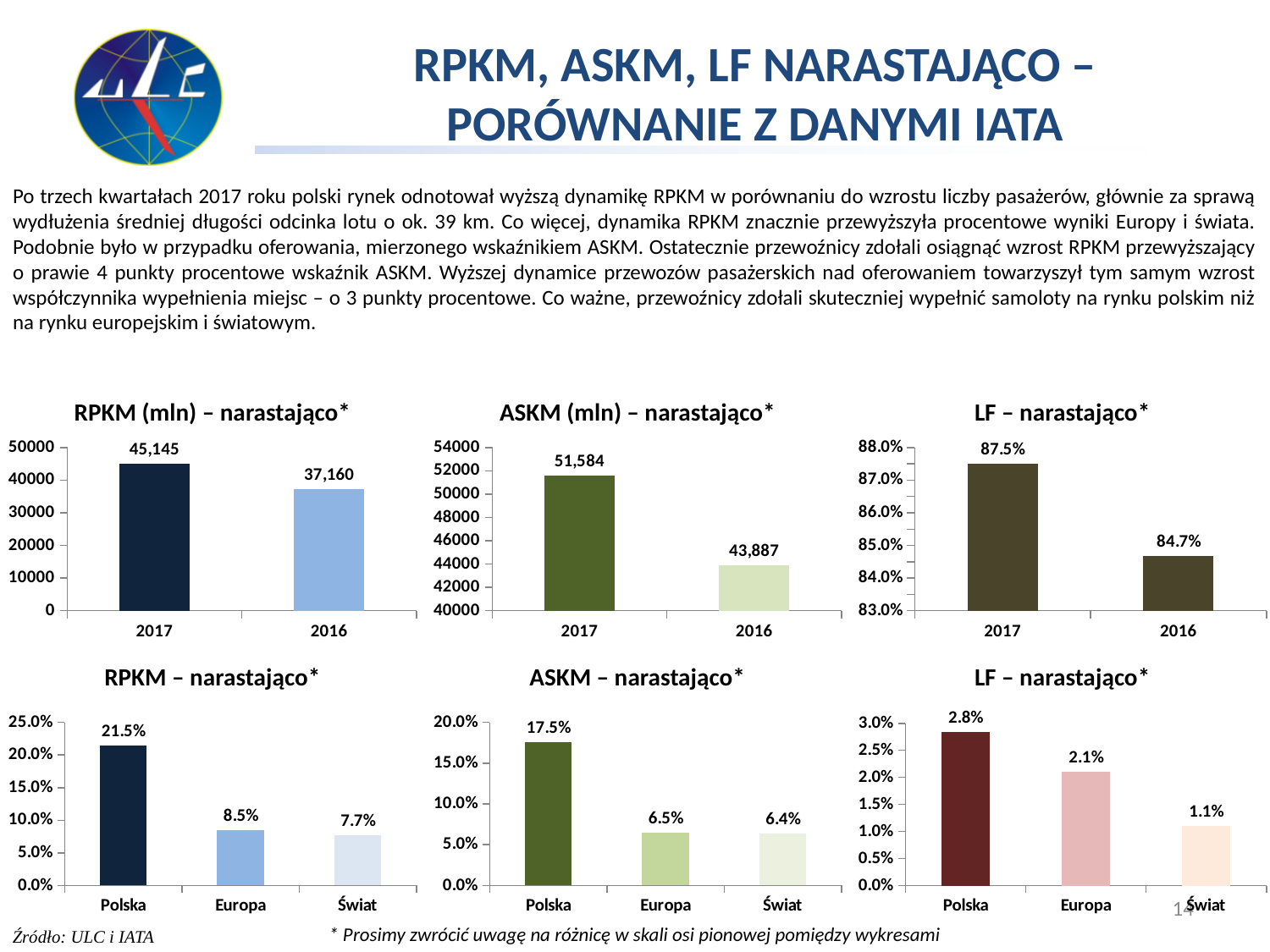
In the top-left chart 'RPKM (mln) – narastająco*', what is the value for 2017? 45,145 In the top-right chart 'LF – narastająco*', what is the difference between the 2017 and 2016 values? 2.8% In the top-middle chart 'ASKM (mln) – narastająco*', what is the value for 2016? 43,887 In the bottom-left chart 'RPKM – narastająco*', which category has the highest value? Polska What type of chart is the bottom-middle chart 'ASKM – narastająco*'? bar chart In the bottom-right chart 'LF – narastająco*', what is the value for Polska? 2.8% In the bottom-left chart 'RPKM – narastająco*', how many categories are shown? 3 In the bottom-right chart 'LF – narastająco*', which category has the lowest value? Świat In the top-left chart 'RPKM (mln) – narastająco*', what is the difference between the 2017 and 2016 values? 7,985 In the top-middle chart 'ASKM (mln) – narastająco*', is the value for 2017 larger or smaller than the value for 2016? larger In the top-right chart 'LF – narastająco*', what is the value for 2017? 87.5% In the bottom-middle chart 'ASKM – narastająco*', what is the value for Europa? 6.5%